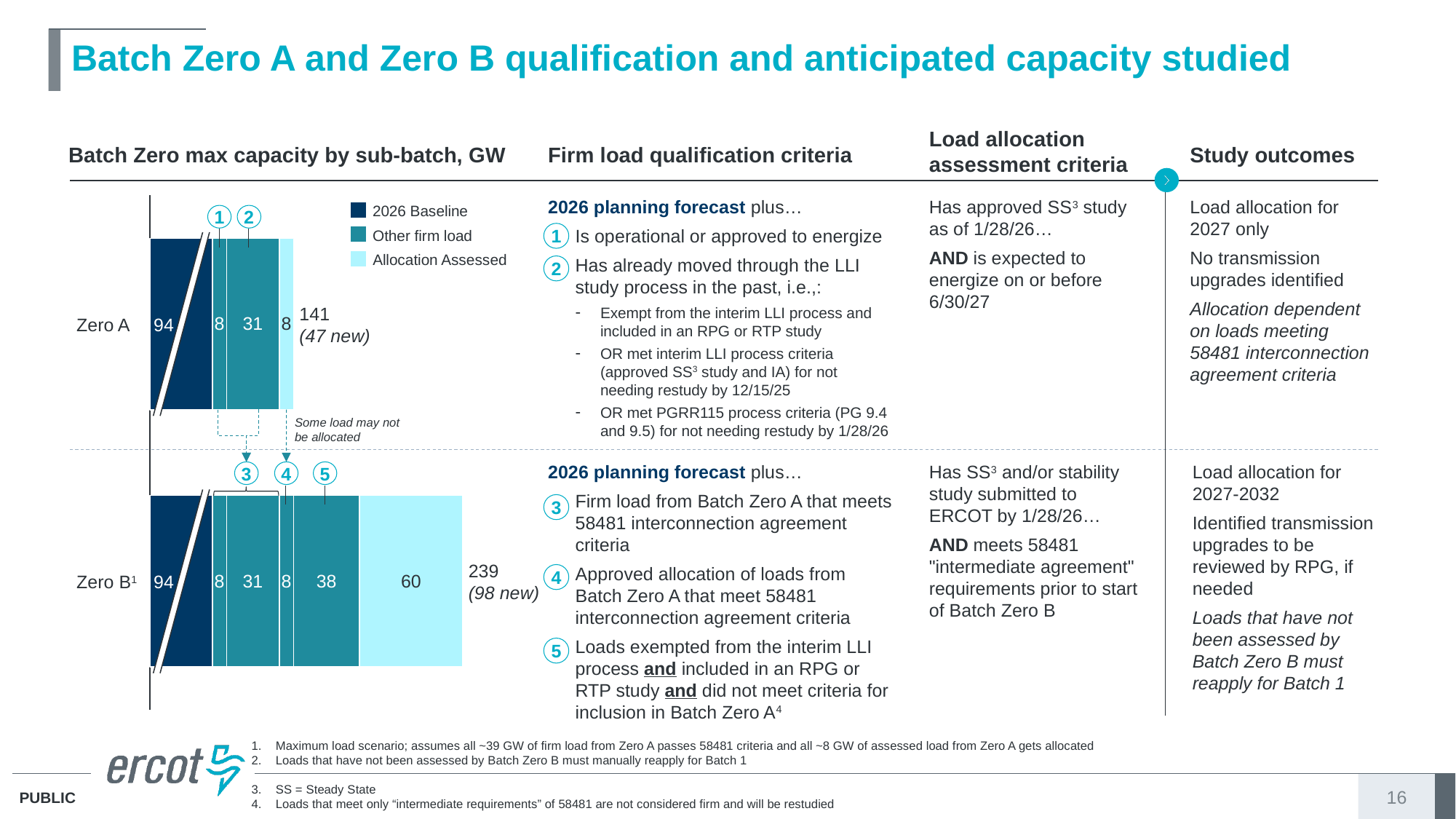
What is the total capacity shown for the Zero A bar in the Batch Zero max capacity chart? 141 What type of chart is used to show Batch Zero max capacity by sub-batch? Stacked bar chart What is the 2026 Baseline value for Zero A in the Batch Zero max capacity chart? 94 What is the Allocation Assessed value (the lightest segment) for Zero A in the Batch Zero max capacity chart? 8 What unit is stated in the title of the Batch Zero max capacity chart? GW What is the difference between the total capacity of Zero B and Zero A in the Batch Zero max capacity chart? 98 How many series does the legend of the Batch Zero max capacity chart list? 3 What is the total capacity shown for the Zero B bar in the Batch Zero max capacity chart? 239 How much new capacity is noted next to the Zero A bar in the Batch Zero max capacity chart? 47 new How much new capacity is noted next to the Zero B bar in the Batch Zero max capacity chart? 98 new What is the Allocation Assessed value (the lightest segment) for Zero B in the Batch Zero max capacity chart? 60 Which sub-batch has the larger total capacity in the Batch Zero max capacity chart, Zero A or Zero B? Zero B